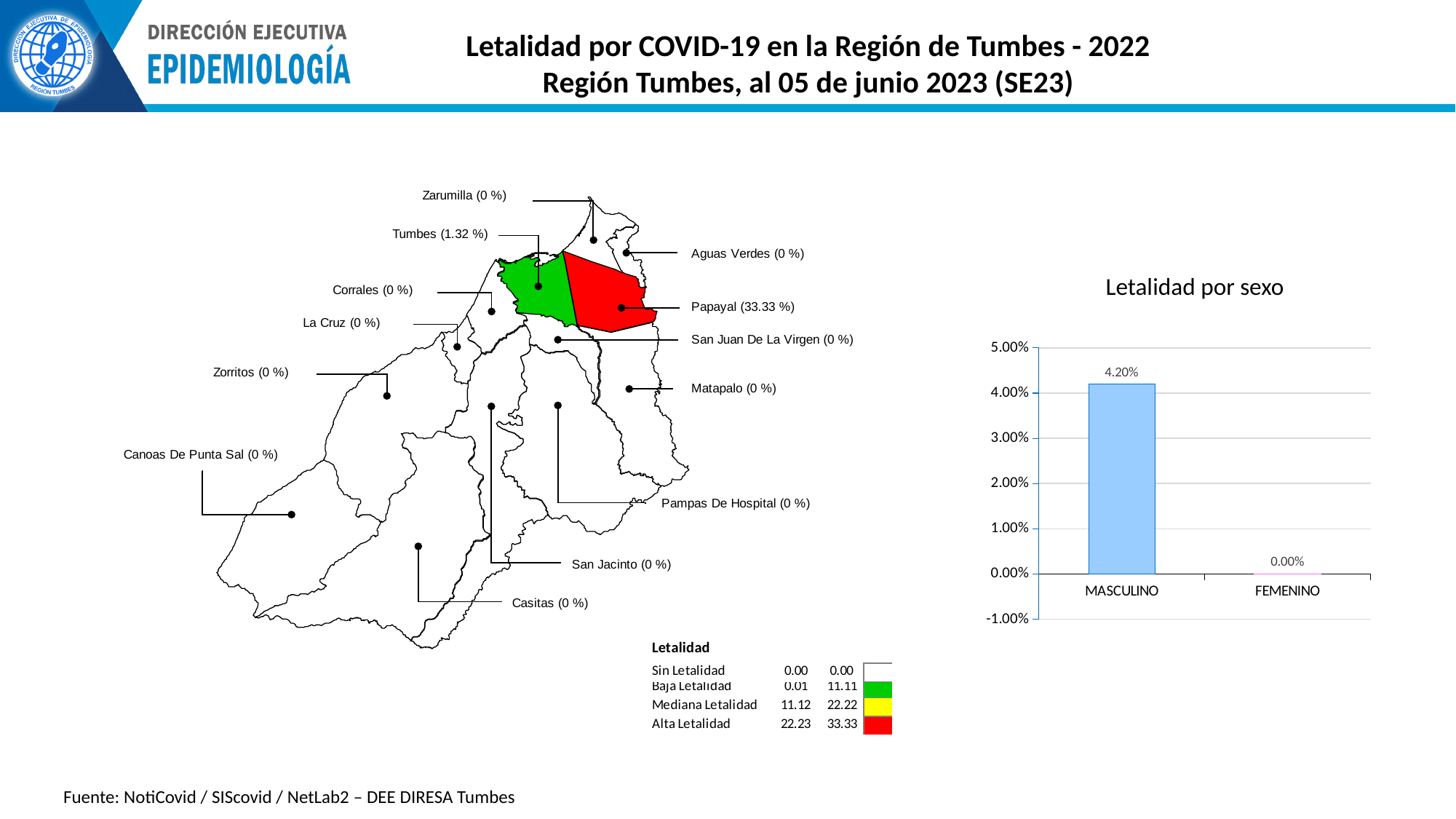
In the 'Letalidad por sexo' chart, which category has the lowest value? FEMENINO In the 'Letalidad por sexo' chart, is the value for MASCULINO greater or less than 4.00%? greater In the 'Letalidad por sexo' chart, which is larger, the value for MASCULINO or for FEMENINO? MASCULINO How many categories are shown on the x axis of the 'Letalidad por sexo' chart? 2 On the map, what lethality percentage is shown for Papayal? 33.33 % In the 'Letalidad por sexo' chart, what is the value for MASCULINO? 4.20% In the 'Letalidad por sexo' chart, what is the difference between the MASCULINO and FEMENINO values? 4.20% On the map, what lethality percentage is shown for Tumbes? 1.32 % In the 'Letalidad por sexo' chart, which category has the highest value? MASCULINO In the 'Letalidad por sexo' chart, what is the value for FEMENINO? 0.00% What is the title of the bar chart on the right side of the slide? Letalidad por sexo What kind of chart is 'Letalidad por sexo'? Bar chart